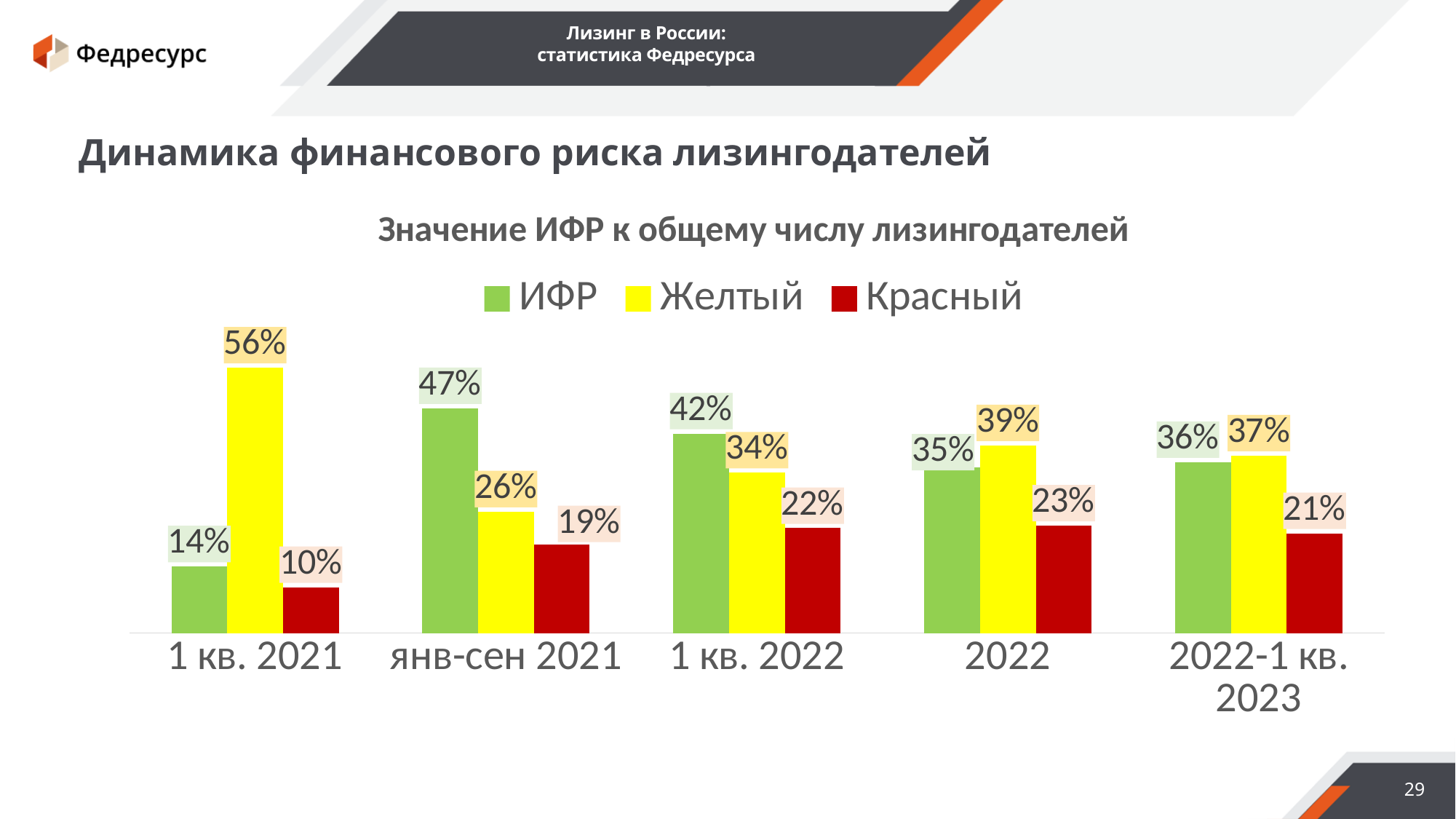
How many periods are shown on the x axis? 5 What is the value of the ИФР series for янв-сен 2021? 47% What is the value of the Желтый series for 1 кв. 2021? 56% What kind of chart is shown on the slide? Bar chart In which period is the Красный series lowest? 1 кв. 2021 What is the title of the chart? Значение ИФР к общему числу лизингодателей What is the value of the Желтый series for 2022-1 кв. 2023? 37% Which is larger for 1 кв. 2022: the ИФР value or the Желтый value? ИФР How many series does the legend list? 3 What is the value of the Красный series for 2022? 23% What is the difference between the Желтый and Красный values for 1 кв. 2021? 46% In which period is the ИФР series highest? янв-сен 2021